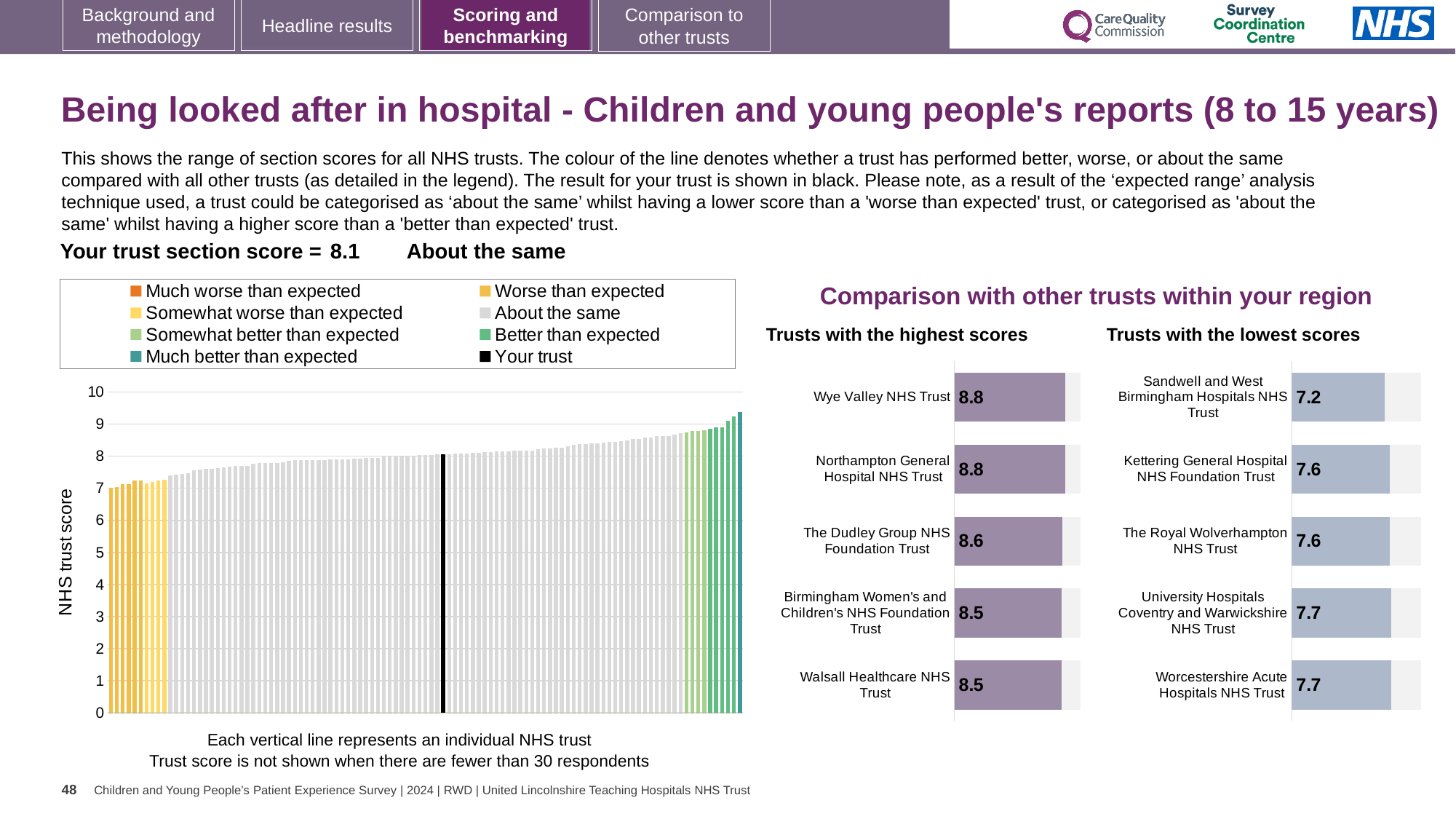
How many entries does the legend above the large chart on the left list? 8 In the 'Trusts with the highest scores' chart, what is the score for The Dudley Group NHS Foundation Trust? 8.6 How many trusts are shown in the 'Trusts with the highest scores' chart? 5 In the large chart on the left, what is the section score for your trust (the black line)? 8.1 Which is larger: the score for The Dudley Group NHS Foundation Trust in the 'Trusts with the highest scores' chart or the score for Kettering General Hospital NHS Foundation Trust in the 'Trusts with the lowest scores' chart? The Dudley Group NHS Foundation Trust In the 'Trusts with the highest scores' chart, what is the score for Wye Valley NHS Trust? 8.8 In the 'Trusts with the lowest scores' chart, what is the difference between the score for Worcestershire Acute Hospitals NHS Trust and the score for Sandwell and West Birmingham Hospitals NHS Trust? 0.5 In the 'Trusts with the lowest scores' chart, which trust has the lowest score? Sandwell and West Birmingham Hospitals NHS Trust In the large chart on the left, is the value of the tallest bar at the far right greater or less than 9? greater In the 'Trusts with the lowest scores' chart, what is the score for Sandwell and West Birmingham Hospitals NHS Trust? 7.2 In the 'Trusts with the highest scores' chart, what is the difference between the score for Wye Valley NHS Trust and the score for Walsall Healthcare NHS Trust? 0.3 In the large chart on the left, do the trust scores rise or fall from left to right? rise